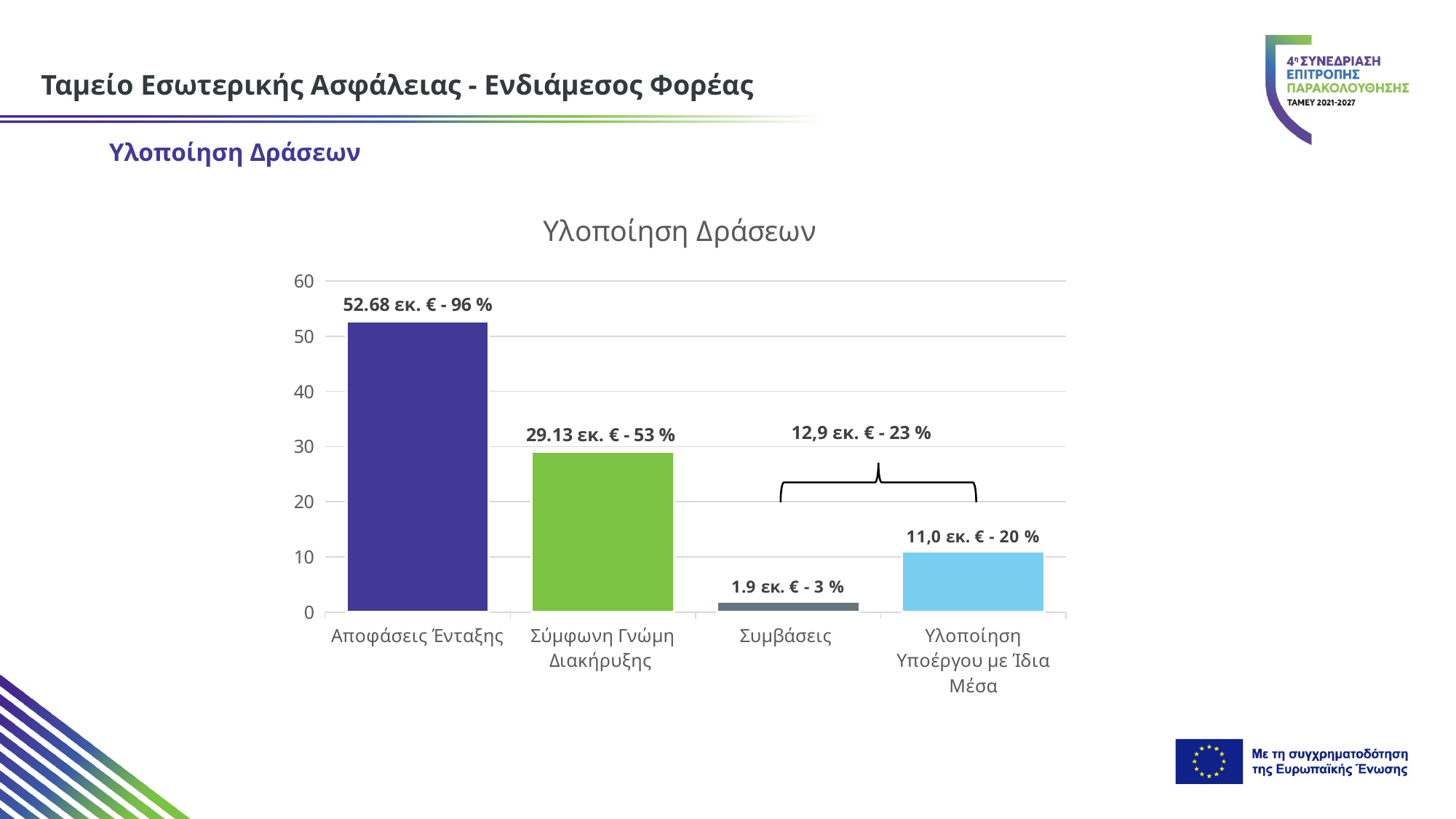
Which is larger, the value for Σύμφωνη Γνώμη Διακήρυξης or the value for Υλοποίηση Υποέργου με Ίδια Μέσα? Σύμφωνη Γνώμη Διακήρυξης What is the title of the chart? Υλοποίηση Δράσεων Which category has the highest value? Αποφάσεις Ένταξης Is the value for Αποφάσεις Ένταξης greater or less than 50? greater What is the data label shown for Αποφάσεις Ένταξης? 52.68 εκ. € - 96 % What is the data label shown for Σύμφωνη Γνώμη Διακήρυξης? 29.13 εκ. € - 53 % What is the data label shown for Υλοποίηση Υποέργου με Ίδια Μέσα? 11,0 εκ. € - 20 % What is the data label shown for Συμβάσεις? 1.9 εκ. € - 3 % Is the value for Σύμφωνη Γνώμη Διακήρυξης greater or less than 30? less What kind of chart is shown on the slide? bar chart How many categories are shown on the x axis? 4 Which category has the lowest value? Συμβάσεις